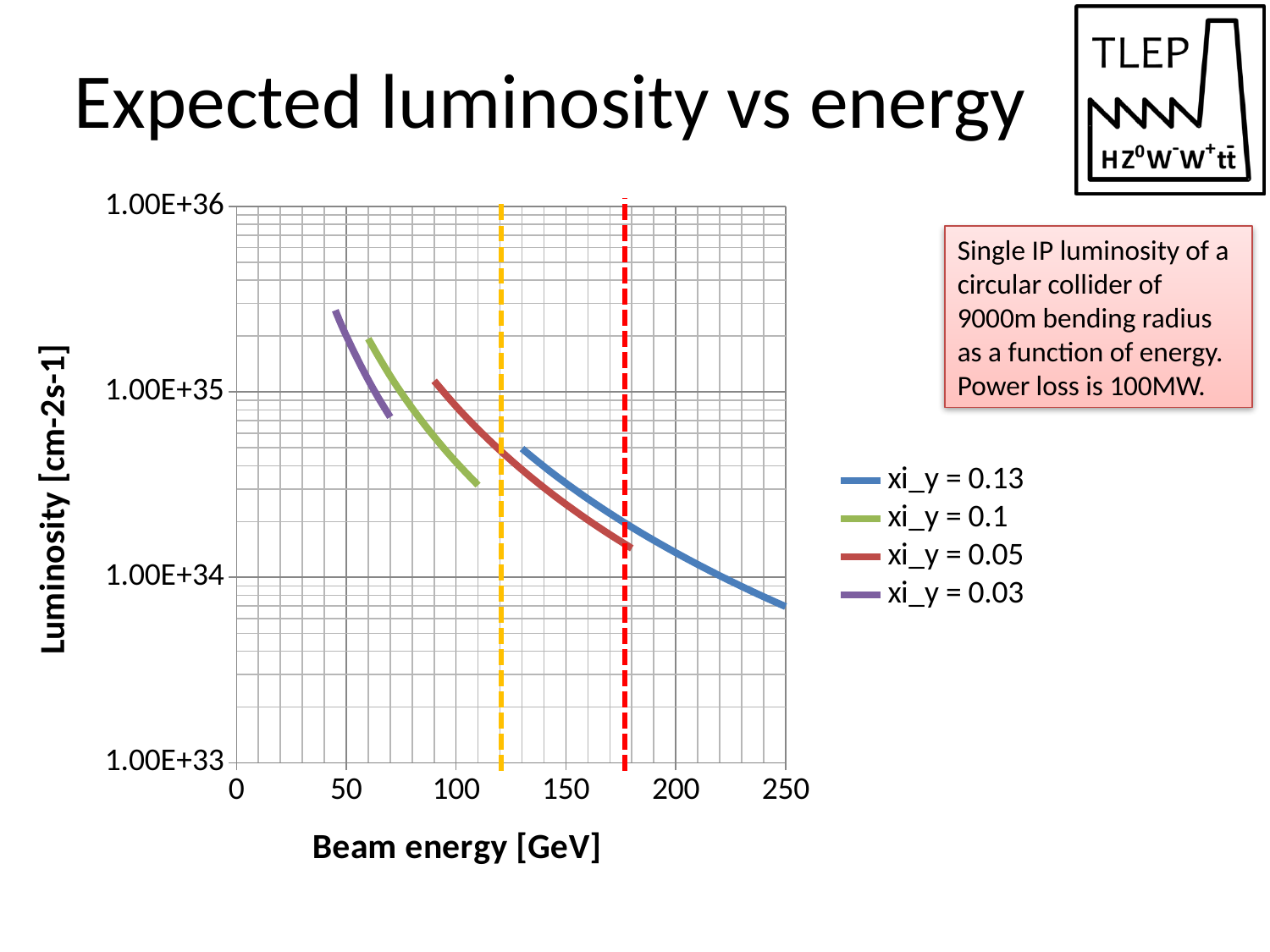
Is the luminosity for xi_y = 0.13 at 250 GeV greater or less than 1.00E+34? less Which series extends to the highest beam energy? xi_y = 0.13 Does luminosity rise or fall as beam energy increases along the x axis? fall At 130 GeV, which series has the higher luminosity, xi_y = 0.13 or xi_y = 0.05? xi_y = 0.13 How many series does the legend list? 4 What kind of chart is shown on the slide? line chart Which series reaches the highest luminosity on the chart? xi_y = 0.03 What is the label of the x axis? Beam energy [GeV] Is the luminosity for xi_y = 0.1 at 110 GeV greater or less than 1.00E+35? less Is the luminosity for xi_y = 0.03 at 50 GeV greater or less than 1.00E+35? greater Which series covers the lowest beam energies? xi_y = 0.03 What is the title of the slide's chart? Expected luminosity vs energy